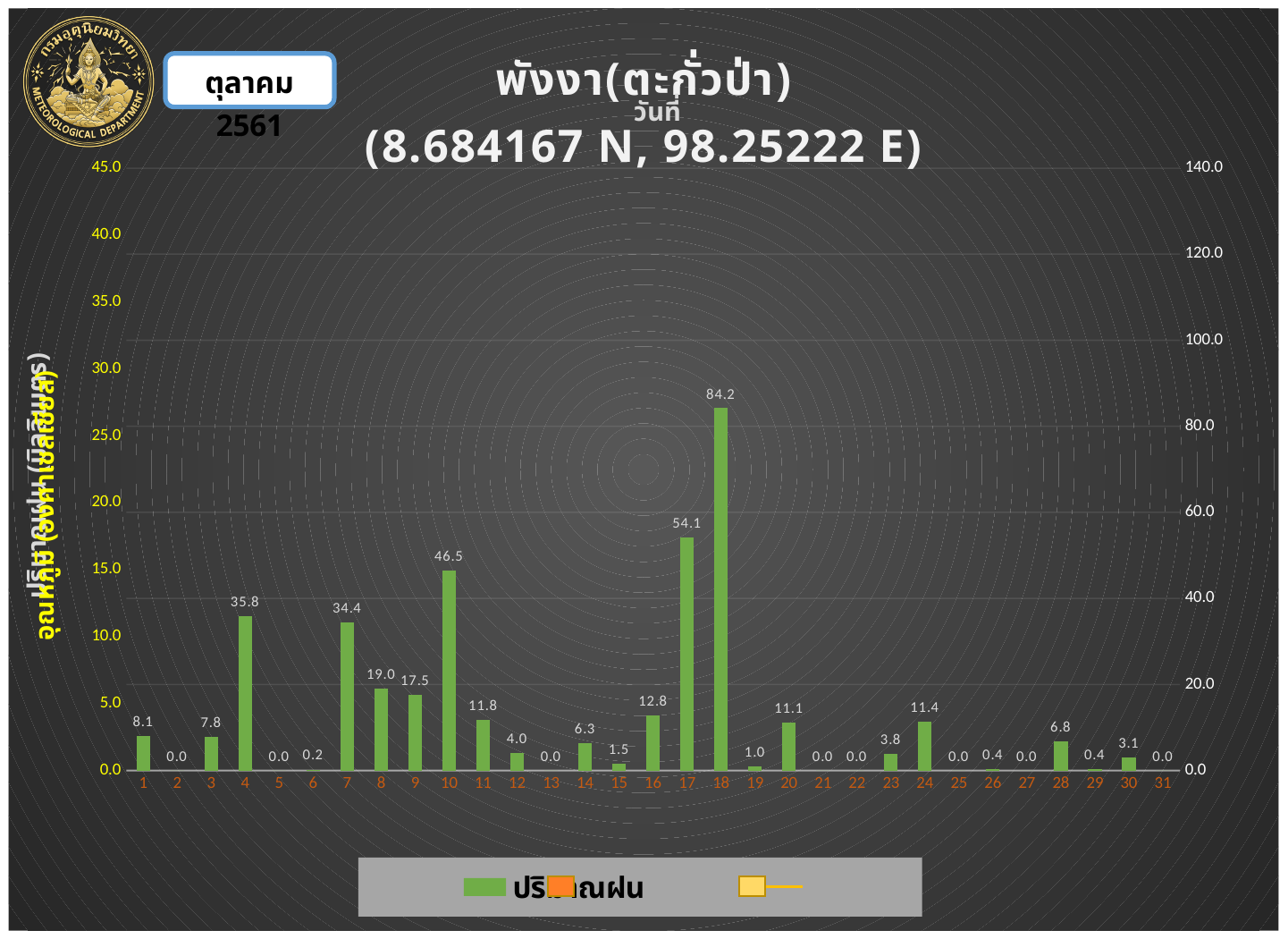
What is the rainfall value shown for day 24? 11.4 Which day has the larger rainfall value, day 8 or day 16? 8 What is the difference between the rainfall values for day 10 and day 4? 10.7 What is the difference between the rainfall values for day 18 and day 17? 30.1 What kind of chart is shown on the slide? bar chart What is the rainfall value shown for day 4? 35.8 What is the rainfall value shown for day 18? 84.2 What month and year are shown in the box at the top left of the slide? ตุลาคม 2561 Which day has the highest rainfall value? 18 How many days are shown on the x axis of the chart? 31 Which day has the larger rainfall value, day 4 or day 7? 4 What is the rainfall value shown for day 10? 46.5